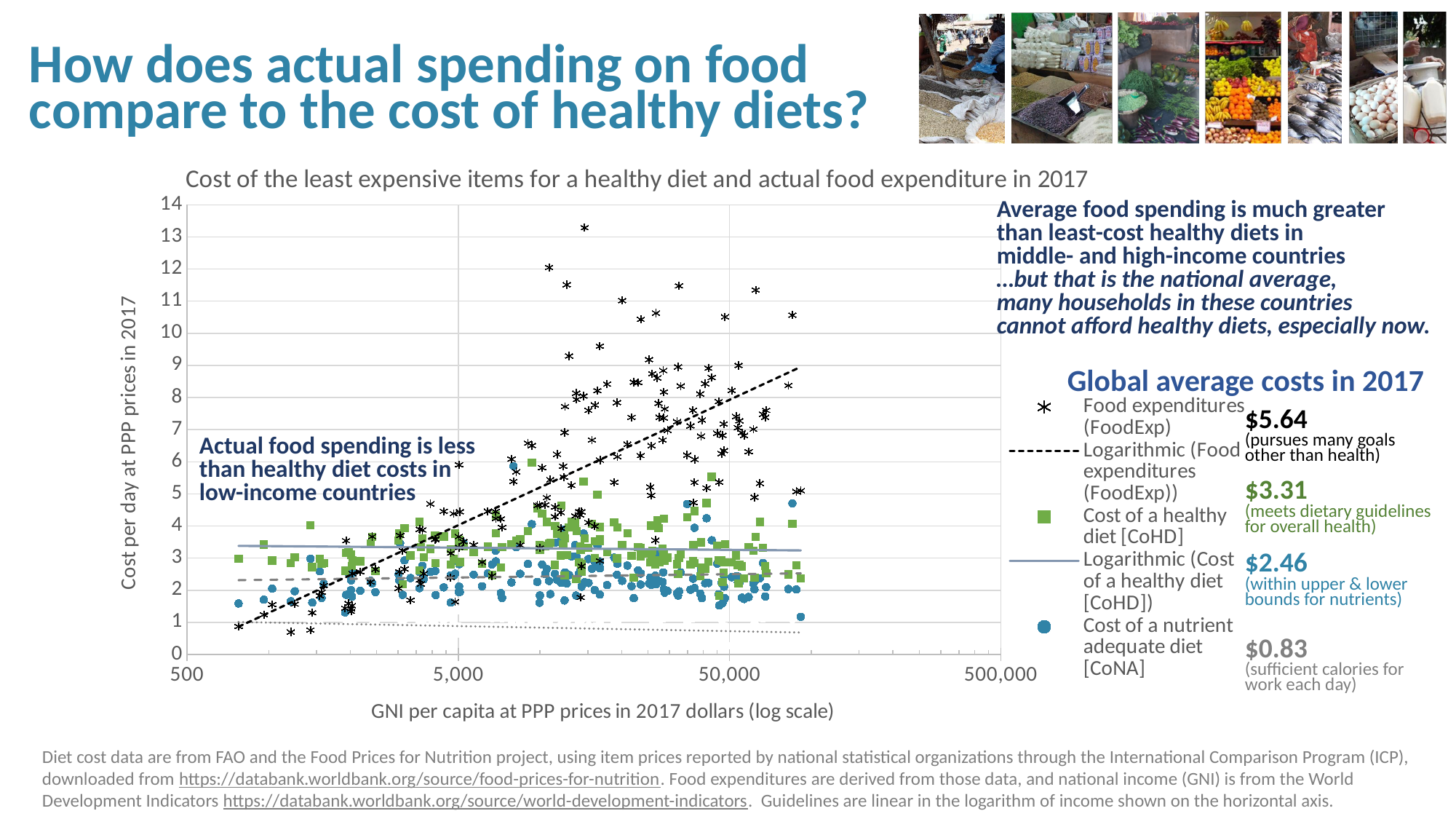
What is the global average cost of a healthy diet [CoHD] in 2017 shown on the slide? $3.31 What is the label of the horizontal axis of the chart? GNI per capita at PPP prices in 2017 dollars (log scale) Does the logarithmic trend line for food expenditures (FoodExp) rise or fall as GNI per capita increases along the x axis? Rise Which is larger: the global average cost of a healthy diet [CoHD] or the global average cost of a nutrient adequate diet [CoNA]? Cost of a healthy diet [CoHD] What kind of chart is shown on the slide? Scatter chart How many entries does the chart legend list? 5 What is the highest global average cost listed on the slide for 2017? $5.64 What is the lowest global average cost listed on the slide for 2017? $0.83 What is the global average cost of a nutrient adequate diet [CoNA] in 2017 shown on the slide? $2.46 What is the title of the chart? Cost of the least expensive items for a healthy diet and actual food expenditure in 2017 What is the global average cost of food expenditures (FoodExp) in 2017 shown on the slide? $5.64 What is the difference between the global average food expenditure ($5.64) and the global average cost of a healthy diet ($3.31)? $2.33